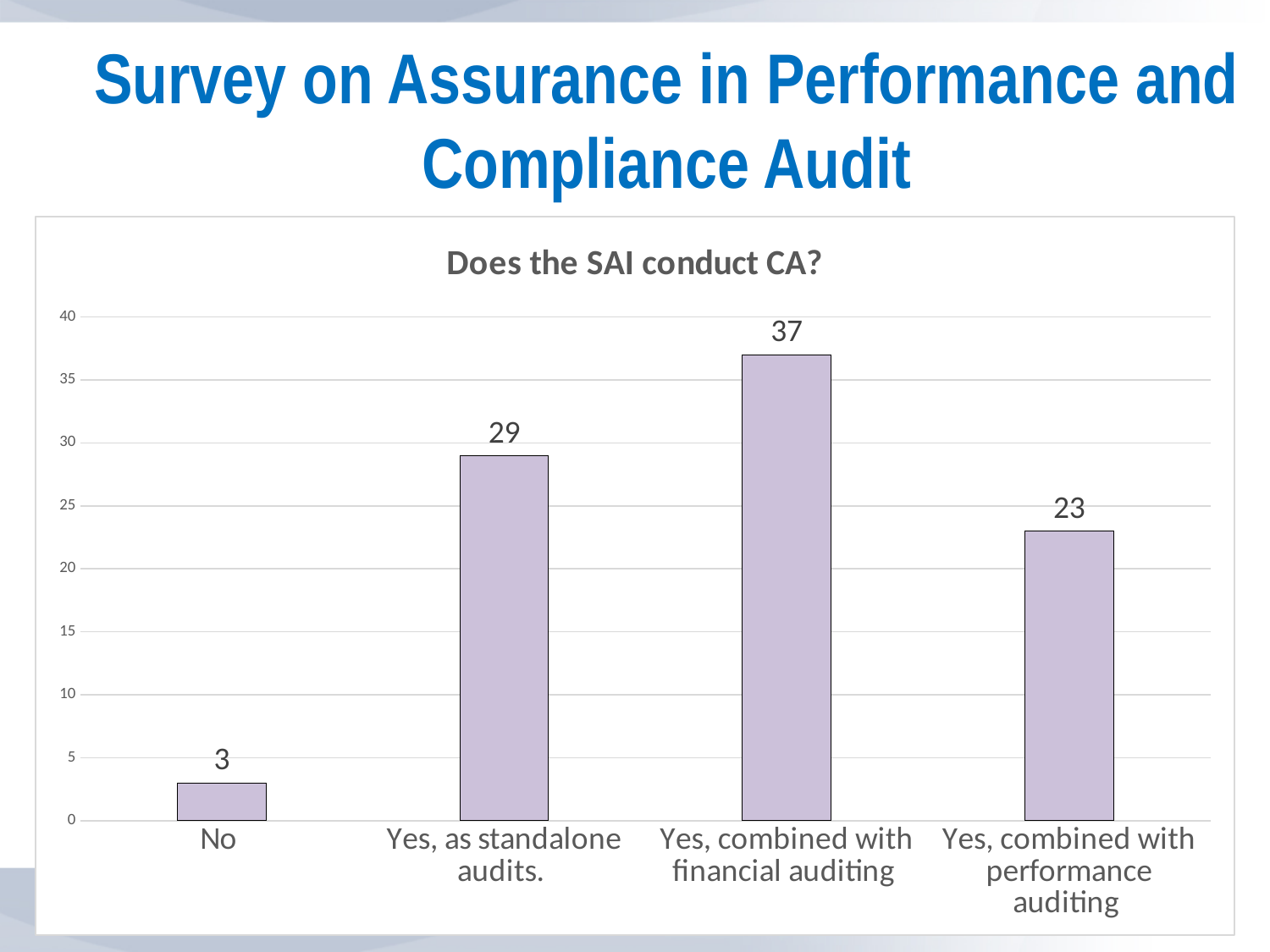
What kind of chart is shown on the slide? bar chart Which category has the highest value? Yes, combined with financial auditing How many categories are shown on the x axis? 4 What is the value for "Yes, combined with performance auditing"? 23 Which category has the lowest value? No What is the value for "Yes, combined with financial auditing"? 37 What is the difference between the values for "Yes, combined with financial auditing" and "Yes, as standalone audits."? 8 What is the value for "Yes, as standalone audits."? 29 What is the title of the chart? Does the SAI conduct CA? Which is larger, the value for "Yes, as standalone audits." or the value for "Yes, combined with performance auditing"? Yes, as standalone audits. What is the value for "No"? 3 Is the value for "Yes, combined with performance auditing" greater or less than 25? less